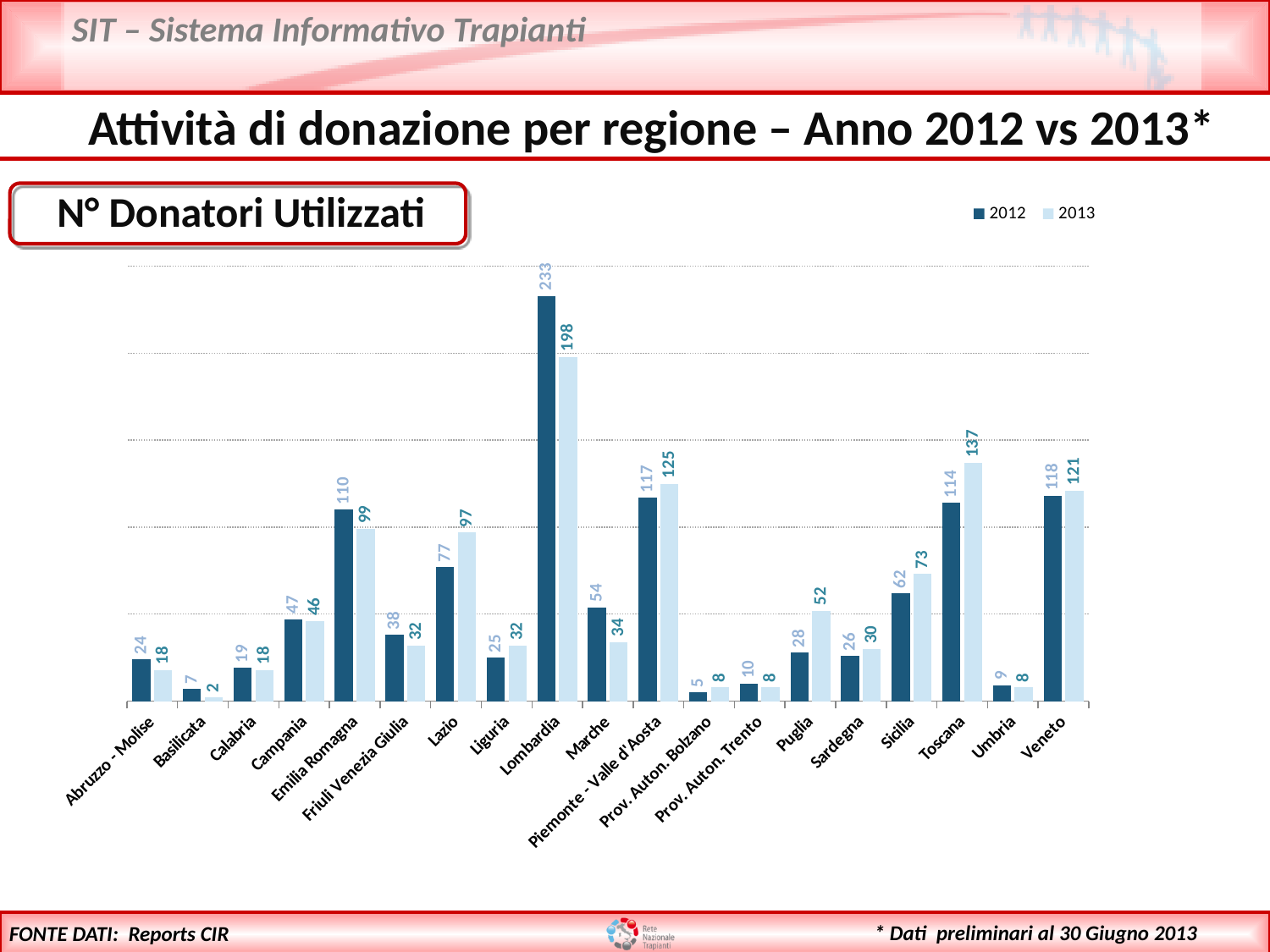
What is the difference between the 2013 values for Puglia and Sardegna? 22 Which region has the highest 2013 value? Lombardia How many series does the legend list? 2 What is the 2013 value for Toscana? 137 What is the difference between the 2012 and 2013 values for Lombardia? 35 Which region has the lowest 2012 value? Prov. Auton. Bolzano What kind of chart is shown on the slide? Bar chart What is the 2013 value for Lazio? 97 What is the 2012 value for Lombardia? 233 Which is larger: the 2013 value for Veneto or the 2013 value for Piemonte - Valle d'Aosta? Piemonte - Valle d'Aosta Which is larger for Marche: the 2012 value or the 2013 value? 2012 How many regions are shown on the x axis? 19